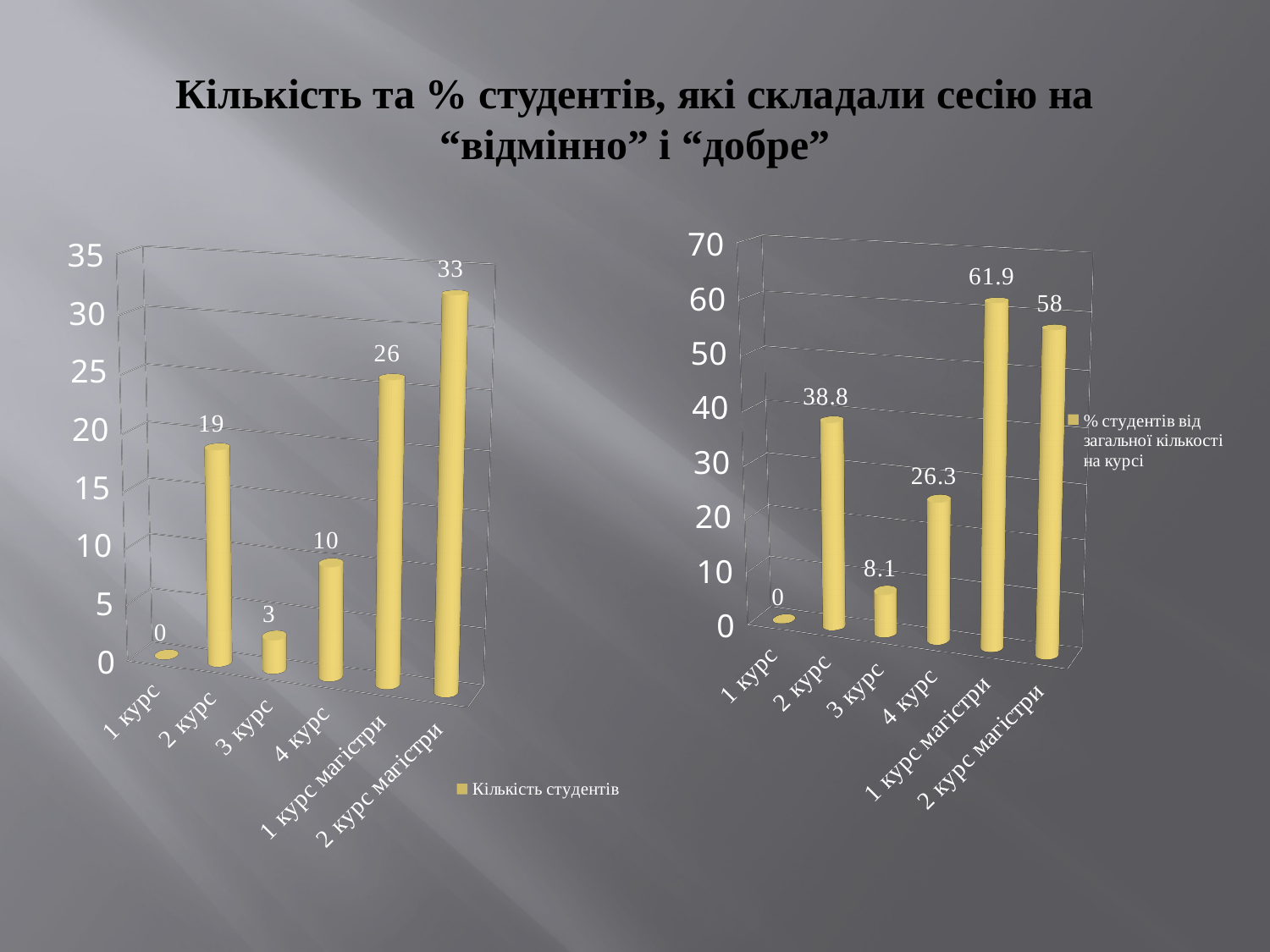
In the left chart (Кількість студентів), what is the value for 2 курс? 19 In the right chart (% студентів), is the value for 2 курс greater or less than 30? greater In the right chart (% студентів), which is larger, the value for 2 курс or the value for 3 курс? 2 курс In the left chart (Кількість студентів), which category has the highest value? 2 курс магістри In the right chart (% студентів), which category has the highest value? 1 курс магістри How many series does the legend of the right chart list? 1 What kind of chart is the left chart (Кількість студентів)? bar chart In the right chart (% студентів), what is the value for 4 курс? 26.3 In the left chart (Кількість студентів), what is the difference between the values for 2 курс магістри and 1 курс магістри? 7 In the left chart (Кількість студентів), how many categories are shown on the x axis? 6 In the right chart (% студентів), what is the difference between the values for 1 курс магістри and 2 курс магістри? 3.9 In the left chart (Кількість студентів), which category has the lowest value? 1 курс